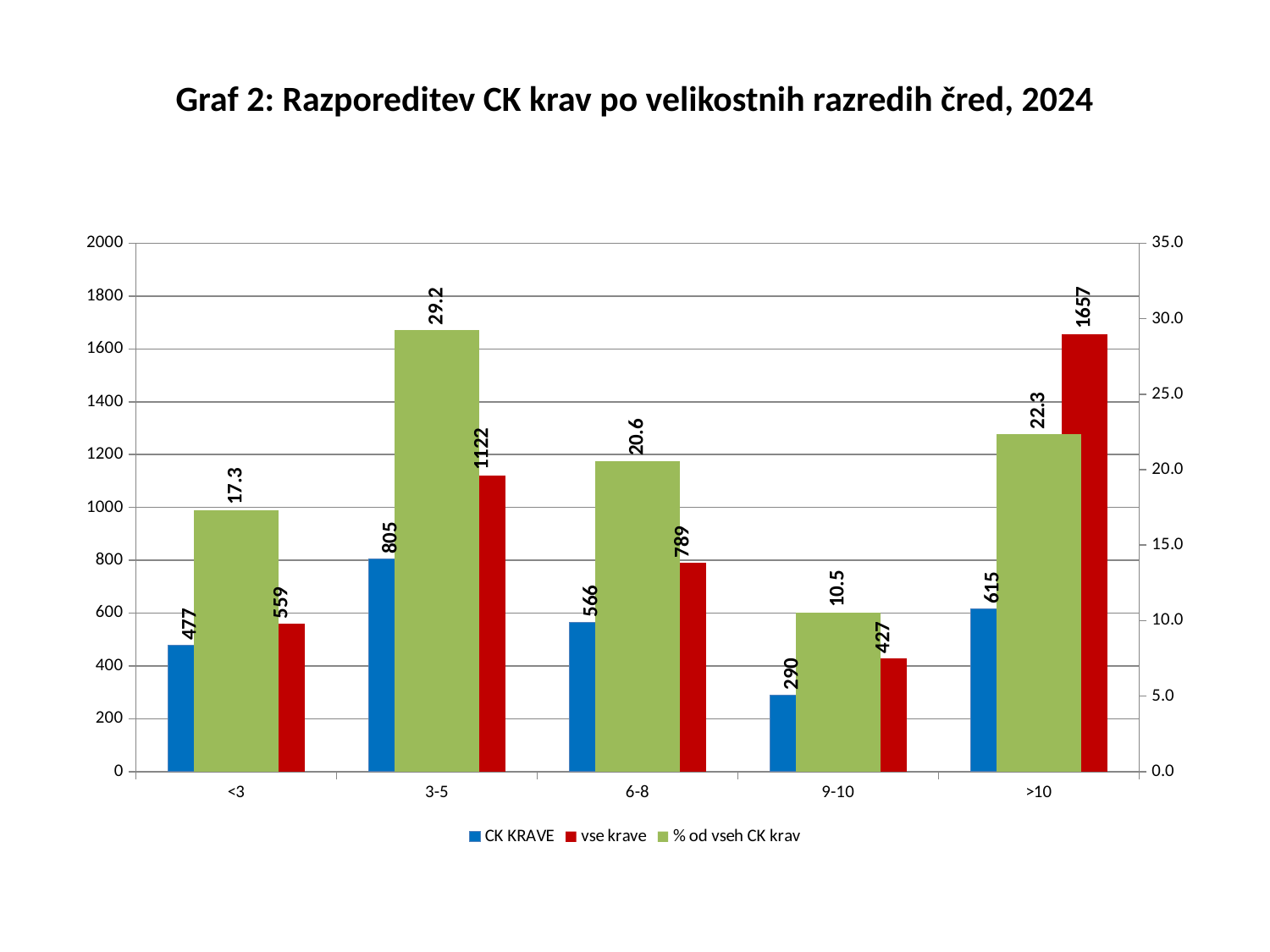
What is the title of the chart? Graf 2: Razporeditev CK krav po velikostnih razredih čred, 2024 Which category has the highest value for % od vseh CK krav? 3-5 What kind of chart is shown on the slide? Bar chart Which category has the highest value for vse krave? >10 Which category has the lowest value for CK KRAVE? 9-10 How many series does the legend list? 3 What is the value of % od vseh CK krav for the 9-10 category? 10.5 What is the value of CK KRAVE for the 3-5 category? 805 How many categories are shown on the x axis? 5 What is the difference between vse krave and CK KRAVE for the <3 category? 82 What is the value of vse krave for the >10 category? 1657 Which is larger: CK KRAVE for 6-8 or CK KRAVE for >10? CK KRAVE for >10